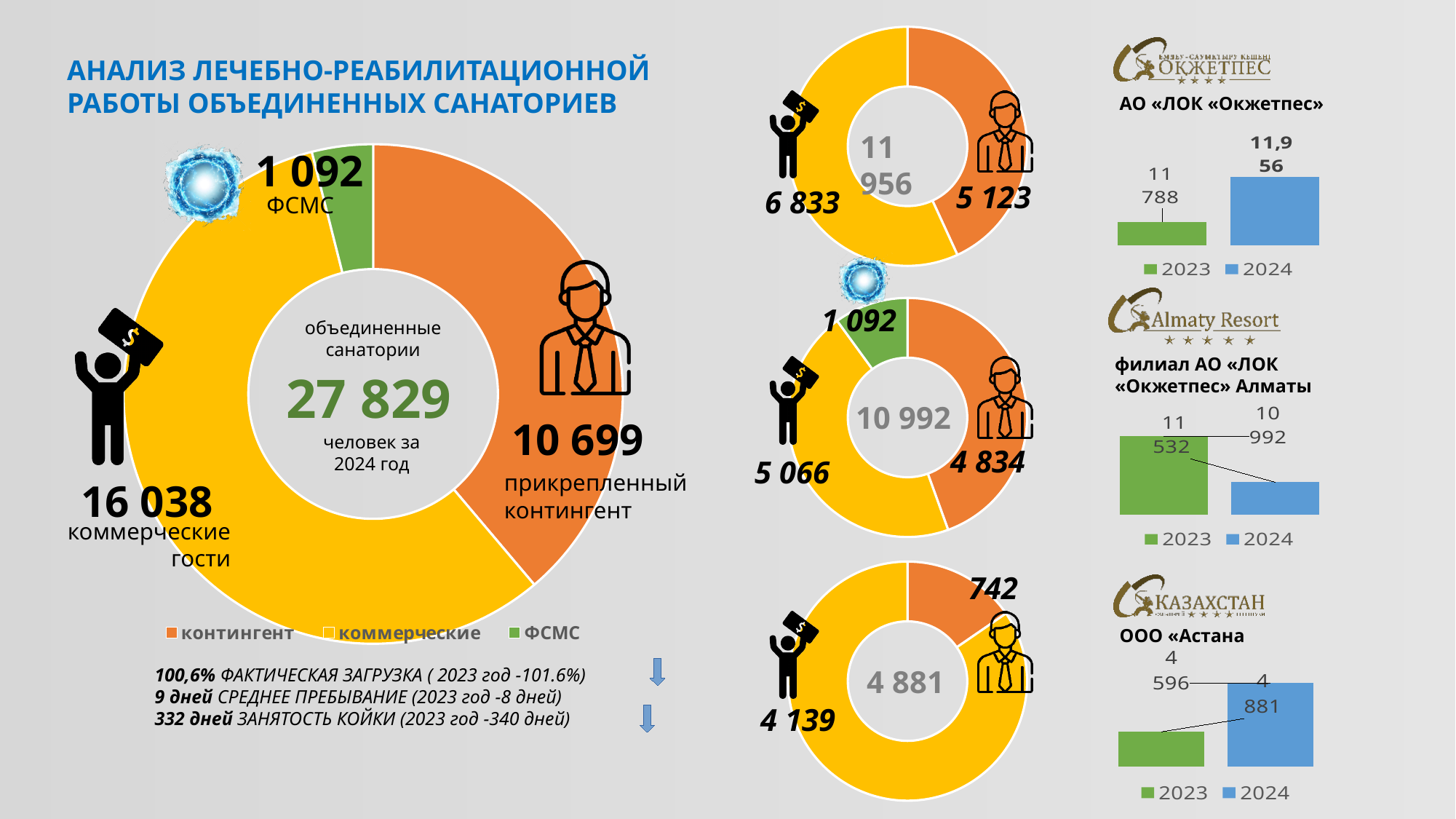
In the bar chart for ООО «Астана», what is the difference between the 2024 value (4 881) and the 2023 value (4 596)? 285 In the large donut chart on the left, what is the value for коммерческие гости? 16 038 In the large donut chart on the left, which category has the largest segment? коммерческие In the bar chart for АО «ЛОК «Окжетпес», what is the value for 2024? 11 956 In the bottom small donut chart in the middle of the slide, what is the value of the orange segment? 742 How many series does the legend of the large donut chart on the left list? 3 In the large donut chart on the left, what is the difference between коммерческие (16 038) and прикрепленный контингент (10 699)? 5 339 In the bar chart for филиал АО «ЛОК «Окжетпес» Алматы, which year has the larger value, 2023 or 2024? 2023 What kind of chart is the large chart on the left of the slide? pie (donut) chart What total number of people for 2024 is shown in the centre of the large donut chart on the left? 27 829 In the large donut chart on the left, what is the value for ФСМС? 1 092 In the large donut chart on the left, which category has the smallest segment? ФСМС